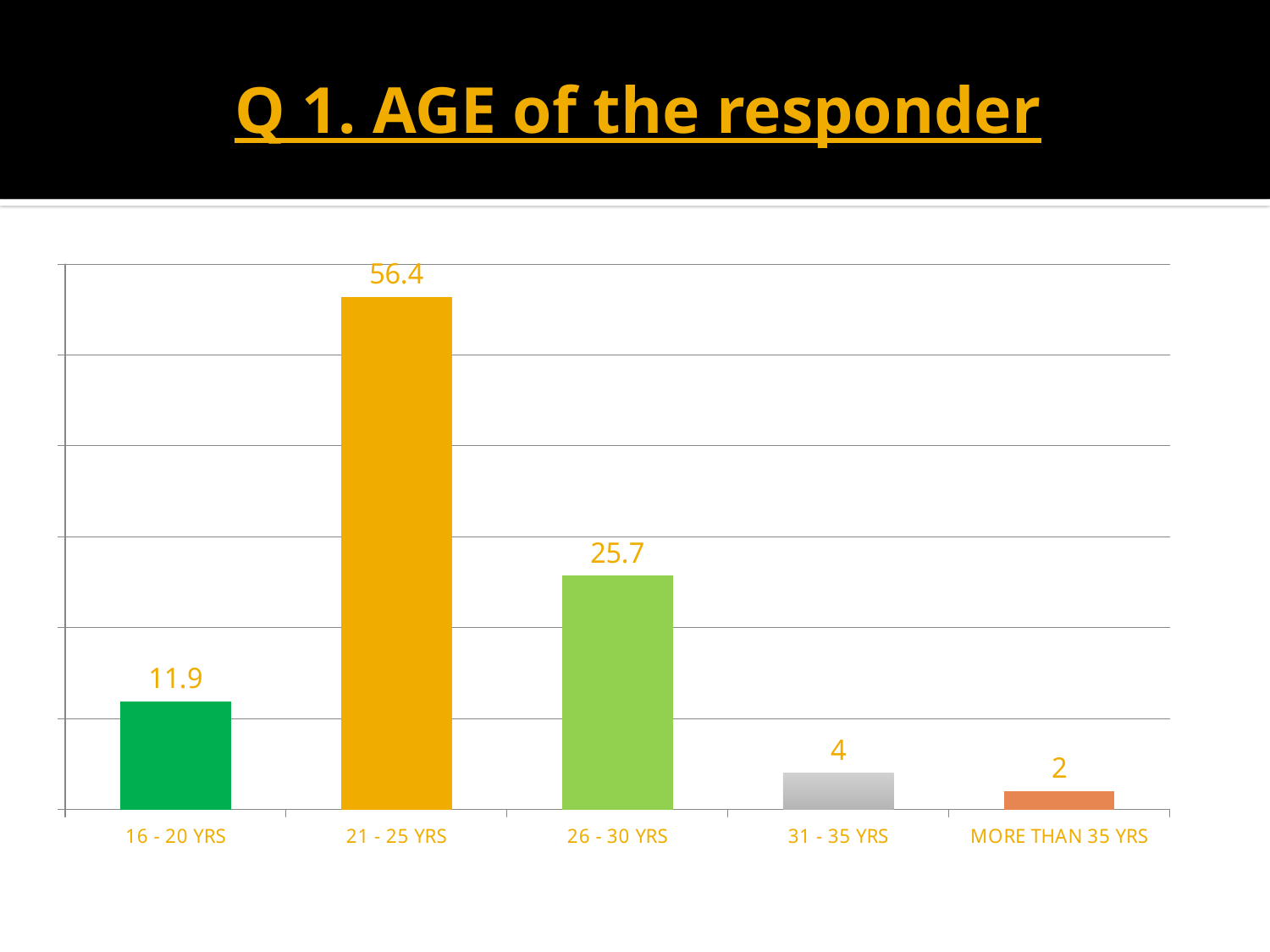
Which age group has the highest value? 21 - 25 YRS What is the title of the slide? Q 1. AGE of the responder What is the difference between the values for 31 - 35 YRS and MORE THAN 35 YRS? 2 What is the difference between the values for 21 - 25 YRS and 26 - 30 YRS? 30.7 What is the value for 21 - 25 YRS? 56.4 How many age categories are shown on the chart? 5 Which age group has the lowest value? MORE THAN 35 YRS What is the value for 26 - 30 YRS? 25.7 What is the value for MORE THAN 35 YRS? 2 Which is larger, the value for 16 - 20 YRS or the value for 31 - 35 YRS? 16 - 20 YRS What kind of chart is shown on the slide? Bar chart What is the value for 16 - 20 YRS? 11.9